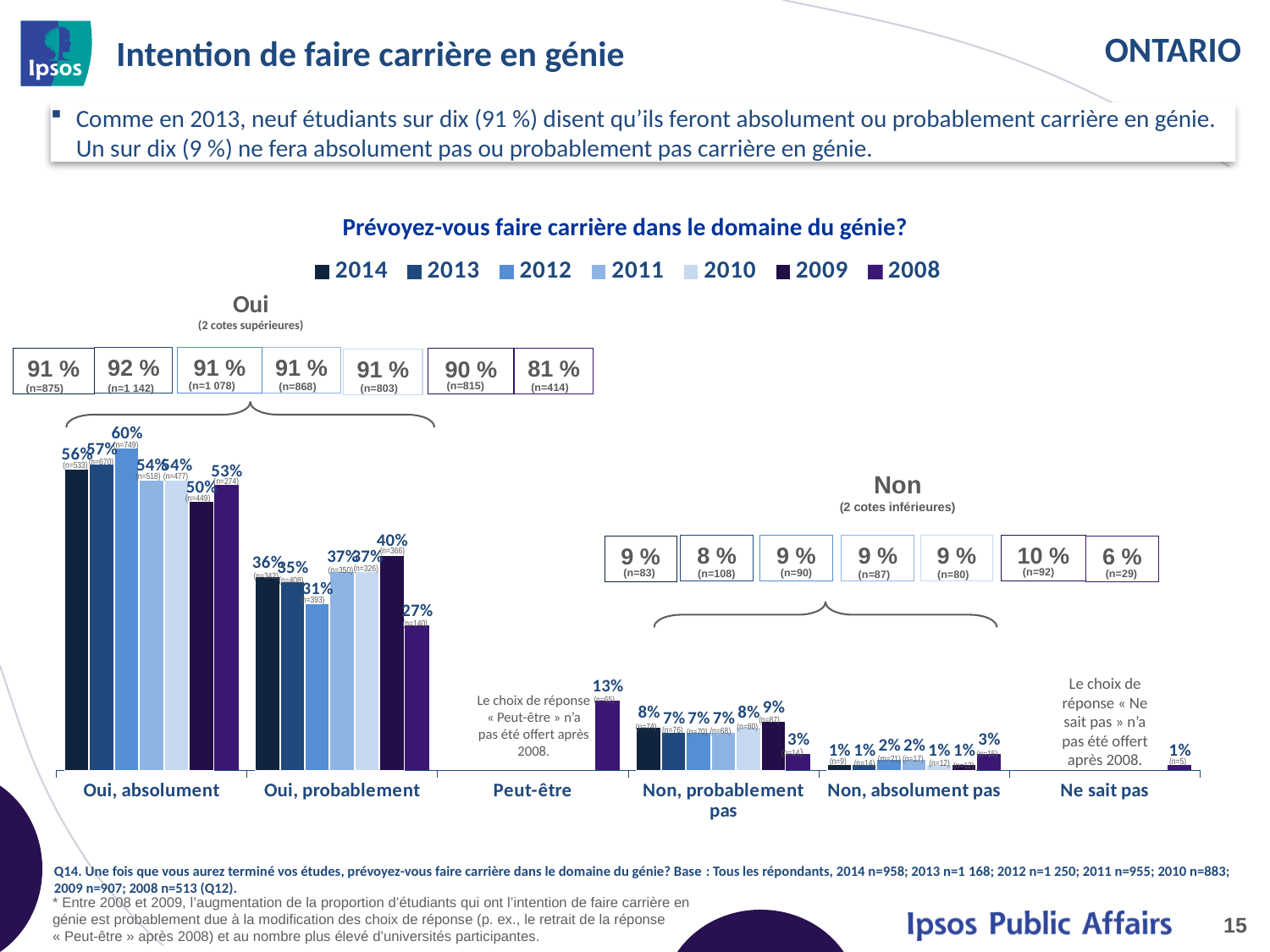
What is the value for 2008 in the 'Non, absolument pas' category? 3% How many response categories are shown along the x axis? 6 What is the title of the chart? Prévoyez-vous faire carrière dans le domaine du génie? Which year has the highest value in the 'Oui, absolument' category? 2012 What is the value for 2008 in the 'Peut-être' category? 13% In the 'Non, probablement pas' category, which is larger: the value for 2009 or the value for 2008? 2009 What is the value for 2009 in the 'Oui, probablement' category? 40% What type of chart is shown on the slide? bar chart What is the difference between the 2012 and 2009 values in the 'Oui, absolument' category? 10 percentage points How many series does the legend list? 7 Which year has the lowest value in the 'Oui, probablement' category? 2008 What is the value for 2012 in the 'Oui, absolument' category? 60%